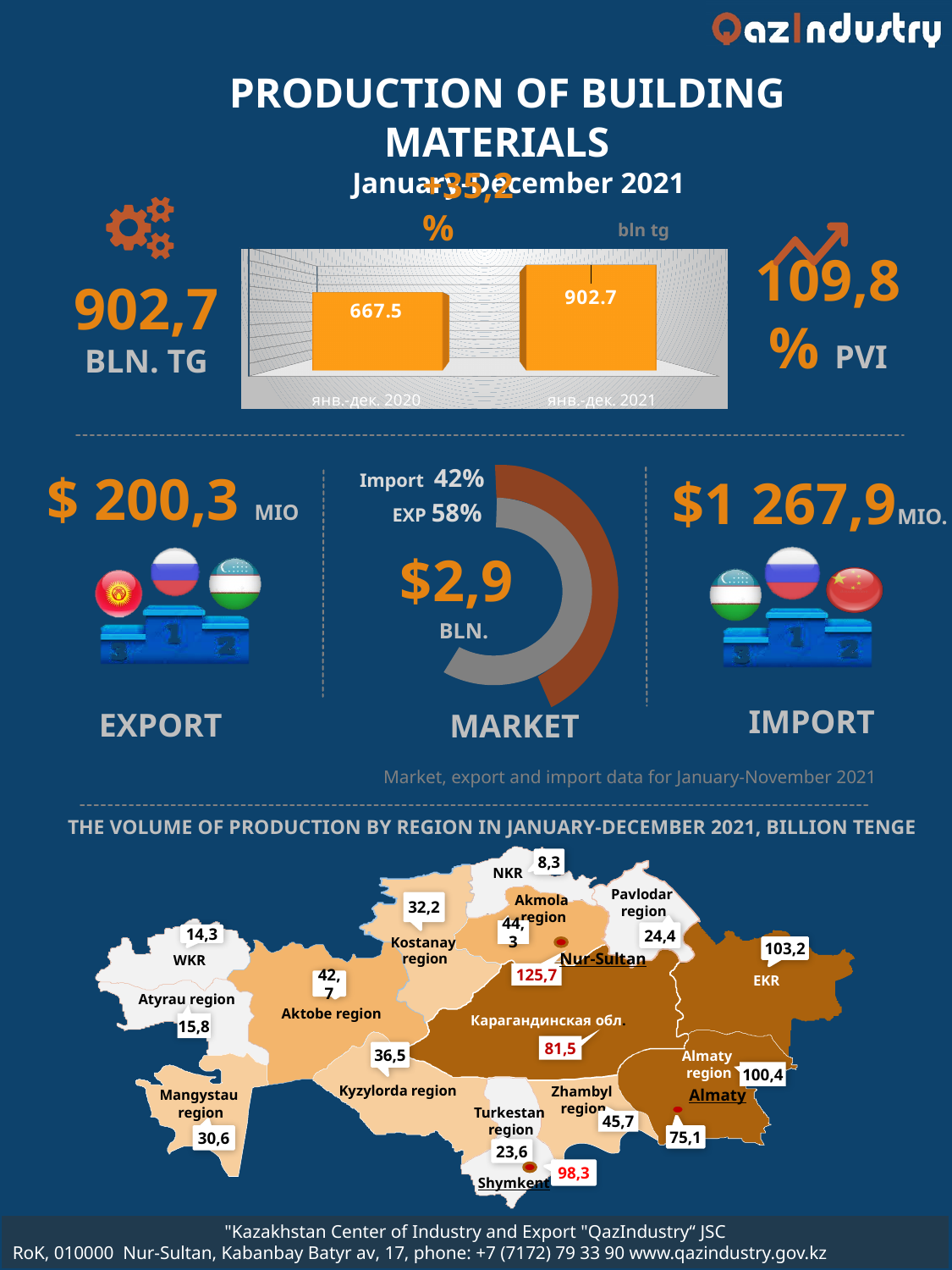
What kind of chart is shown at the top of the slide comparing янв.-дек. 2020 and янв.-дек. 2021? bar chart In the bar chart at the top of the slide, what is the value for янв.-дек. 2020? 667.5 In the bar chart at the top of the slide, which period has the higher value? янв.-дек. 2021 In the bar chart at the top of the slide, what unit is shown above the chart? bln tg In the MARKET donut chart, which is larger, Import or EXP? EXP In the bar chart at the top of the slide, what is the difference between the 2021 and 2020 values? 235.2 In the bar chart at the top of the slide, do the values rise or fall from 2020 to 2021? rise In the bar chart at the top of the slide, what is the value for янв.-дек. 2021? 902.7 In the MARKET donut chart, what total value is shown in the centre? $2,9 BLN. In the MARKET donut chart, what share is EXP? 58% In the bar chart at the top of the slide, how many bars are plotted? 2 In the MARKET donut chart, what share is Import? 42%